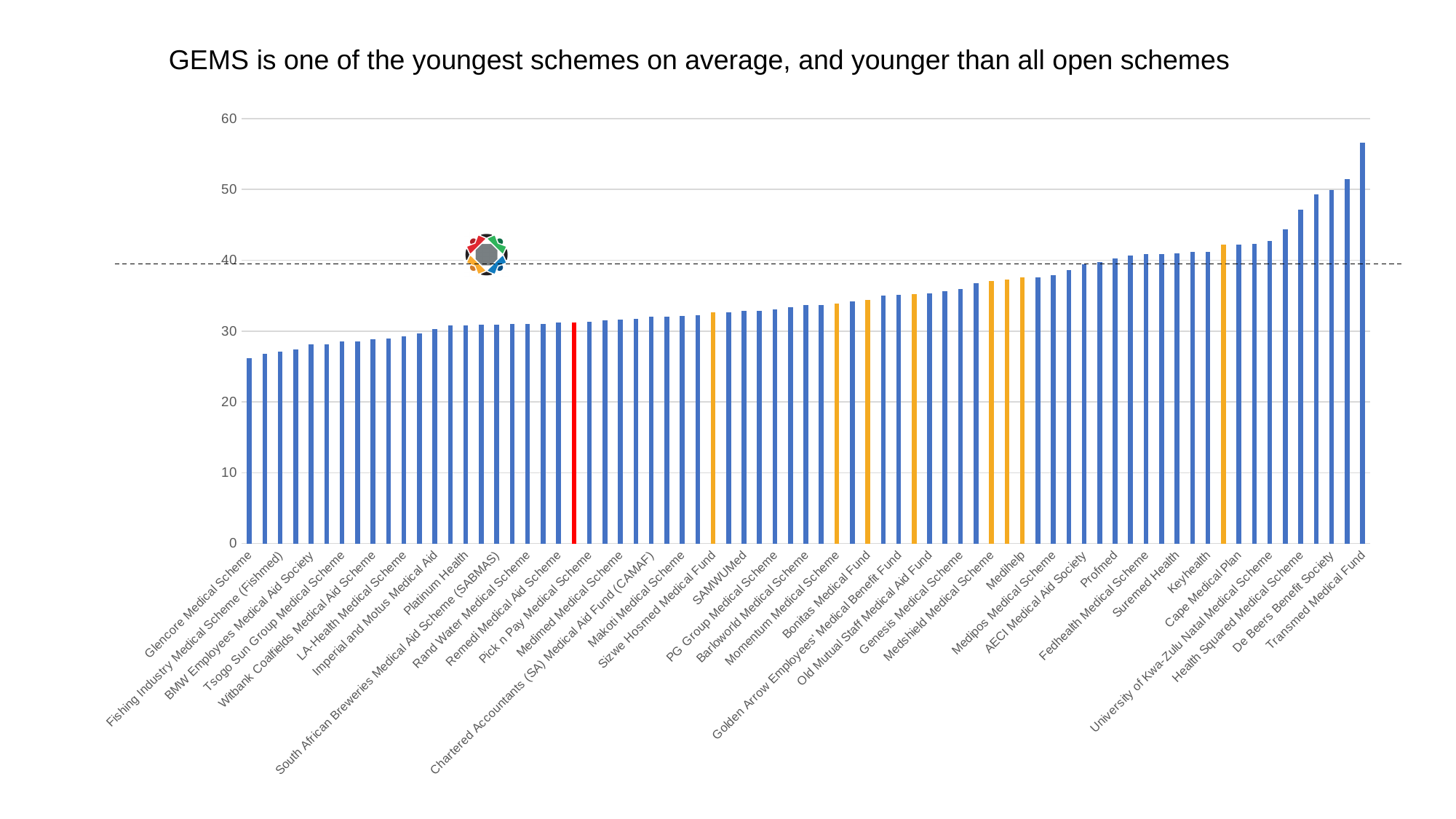
Is the value for Bonitas Medical Fund greater or less than 30? greater Which scheme has the highest bar on the chart? Transmed Medical Fund Is the value for Glencore Medical Scheme greater or less than 30? less Do the bar values rise or fall moving from left to right along the x axis? rise Is the value for Transmed Medical Fund greater or less than 50? greater Which scheme has the lowest bar on the chart? Glencore Medical Scheme Which is larger, the value for Health Squared Medical Scheme or the value for Momentum Medical Scheme? Health Squared Medical Scheme Which is larger, the value for Medihelp or the value for Bonitas Medical Fund? Medihelp What kind of chart is shown on the slide? bar chart At what value on the y axis is the horizontal dashed line drawn? 40